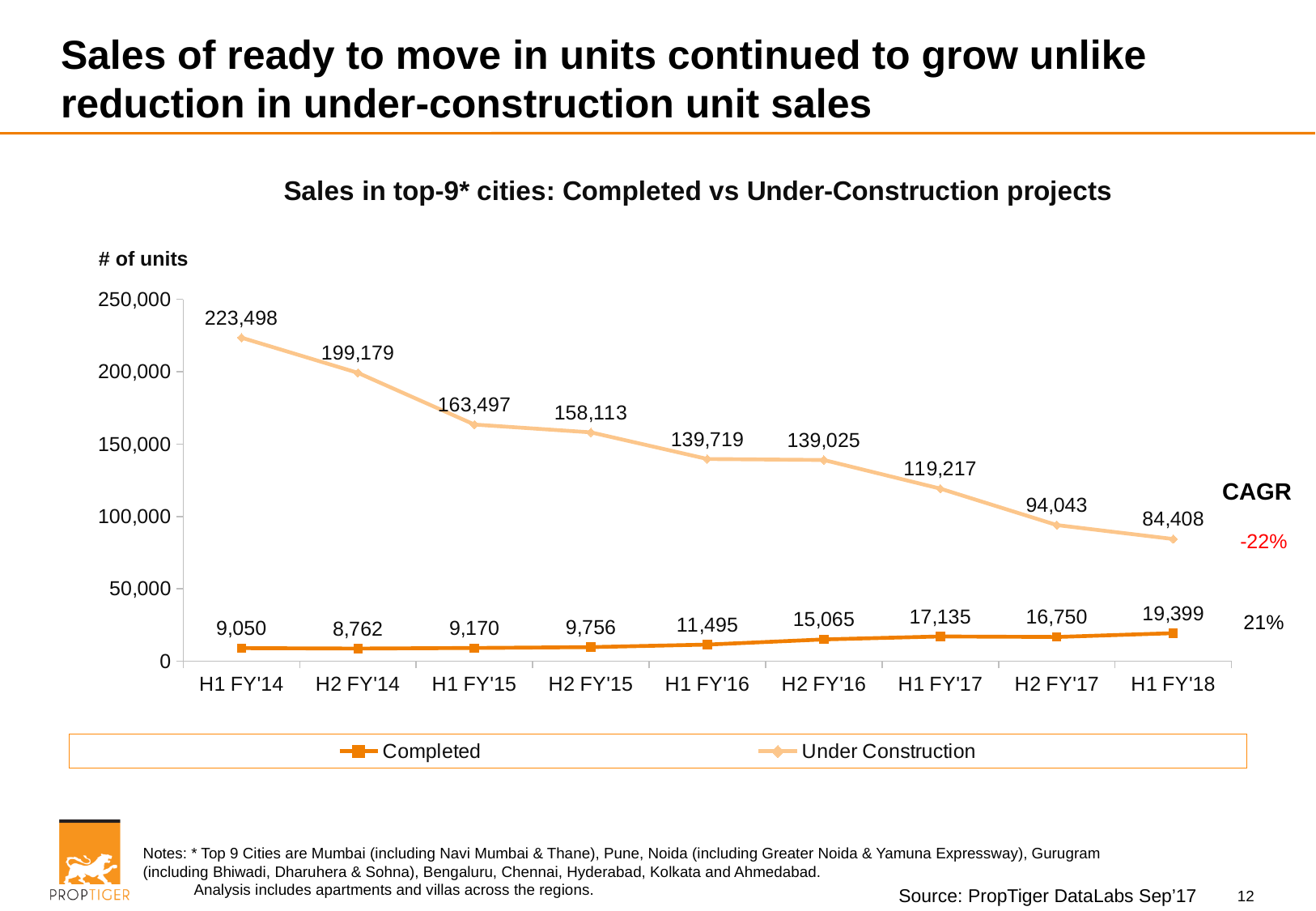
How many series does the legend list? 2 What is the difference between the Under Construction and Completed values in H1 FY'18? 65,009 What is the Under Construction value for H1 FY'14? 223,498 Which is larger: the Completed value in H1 FY'17 or in H2 FY'17? H1 FY'17 What is the Completed value for H1 FY'18? 19,399 In which period is the Under Construction series lowest? H1 FY'18 What kind of chart is this? Line chart What is the Completed value for H2 FY'16? 15,065 How many periods are shown on the x axis? 9 In which period is the Completed series highest? H1 FY'18 Does the Under Construction series rise or fall from H1 FY'14 to H1 FY'18? Fall What CAGR is shown for the Under Construction series? -22%